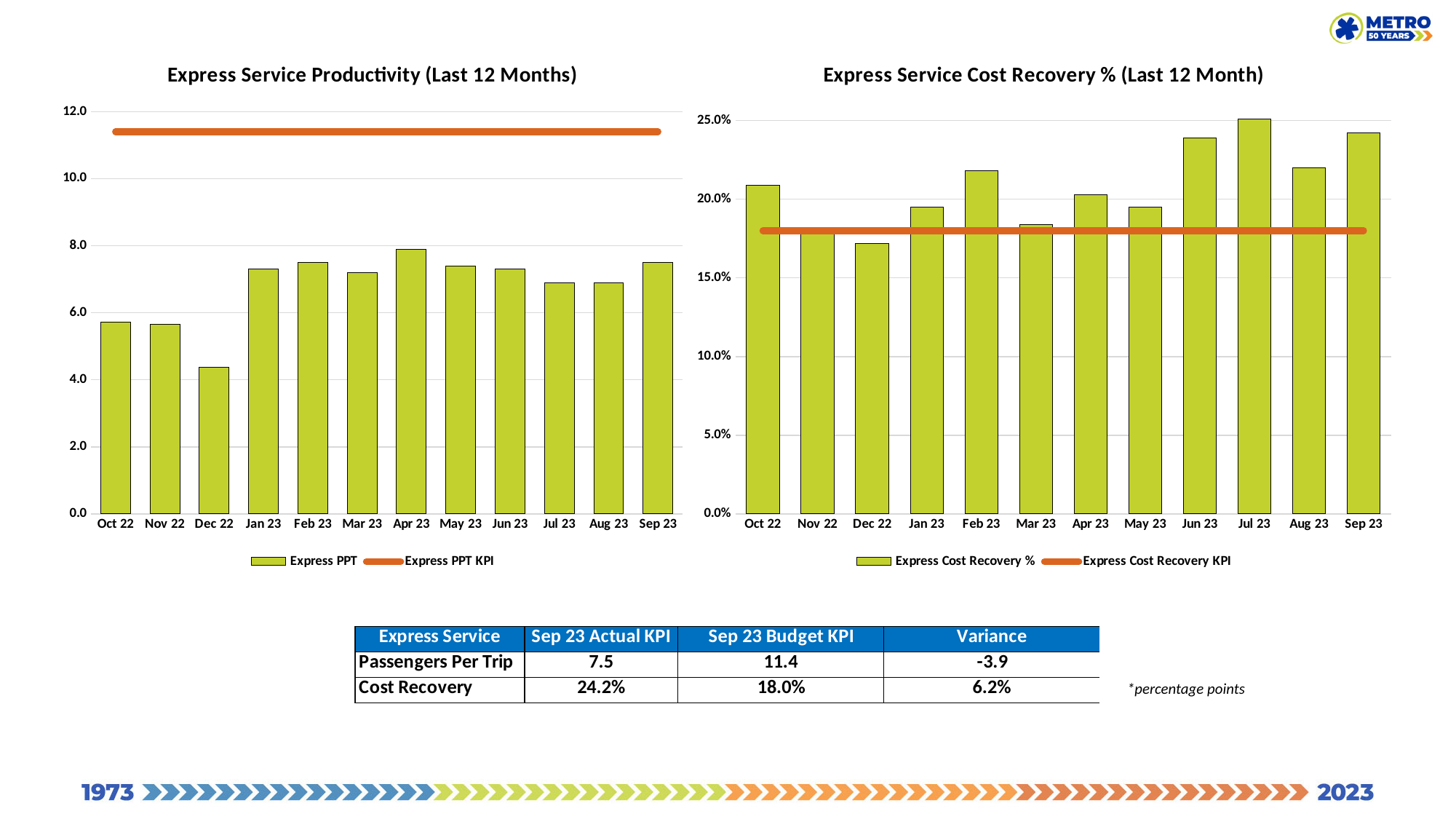
In the Express Service Productivity (Last 12 Months) chart, is the Express PPT value for Dec 22 greater or less than 6.0? less In the Express Service Productivity (Last 12 Months) chart, which month has the highest Express PPT value? Apr 23 In the Express Service Cost Recovery % (Last 12 Month) chart, is the Express Cost Recovery % for Dec 22 greater or less than 20.0%? less What kind of chart is the Express Service Productivity (Last 12 Months) chart? bar chart In the Express Service Productivity (Last 12 Months) chart, which month has the lowest Express PPT value? Dec 22 In the Express Service Cost Recovery % (Last 12 Month) chart, what does the legend call the orange line series? Express Cost Recovery KPI In the Express Service Productivity (Last 12 Months) chart, is the Express PPT value for Jan 23 greater or less than 6.0? greater How many series does the legend of the Express Service Cost Recovery % (Last 12 Month) chart list? 2 In the Express Service Productivity (Last 12 Months) chart, which is larger, the Express PPT value for Oct 22 or for Dec 22? Oct 22 In the Express Service Cost Recovery % (Last 12 Month) chart, which month has the highest Express Cost Recovery %? Jul 23 In the Express Service Cost Recovery % (Last 12 Month) chart, which is larger, the Express Cost Recovery % for Feb 23 or for Mar 23? Feb 23 How many months are shown on the x axis of the Express Service Cost Recovery % (Last 12 Month) chart? 12